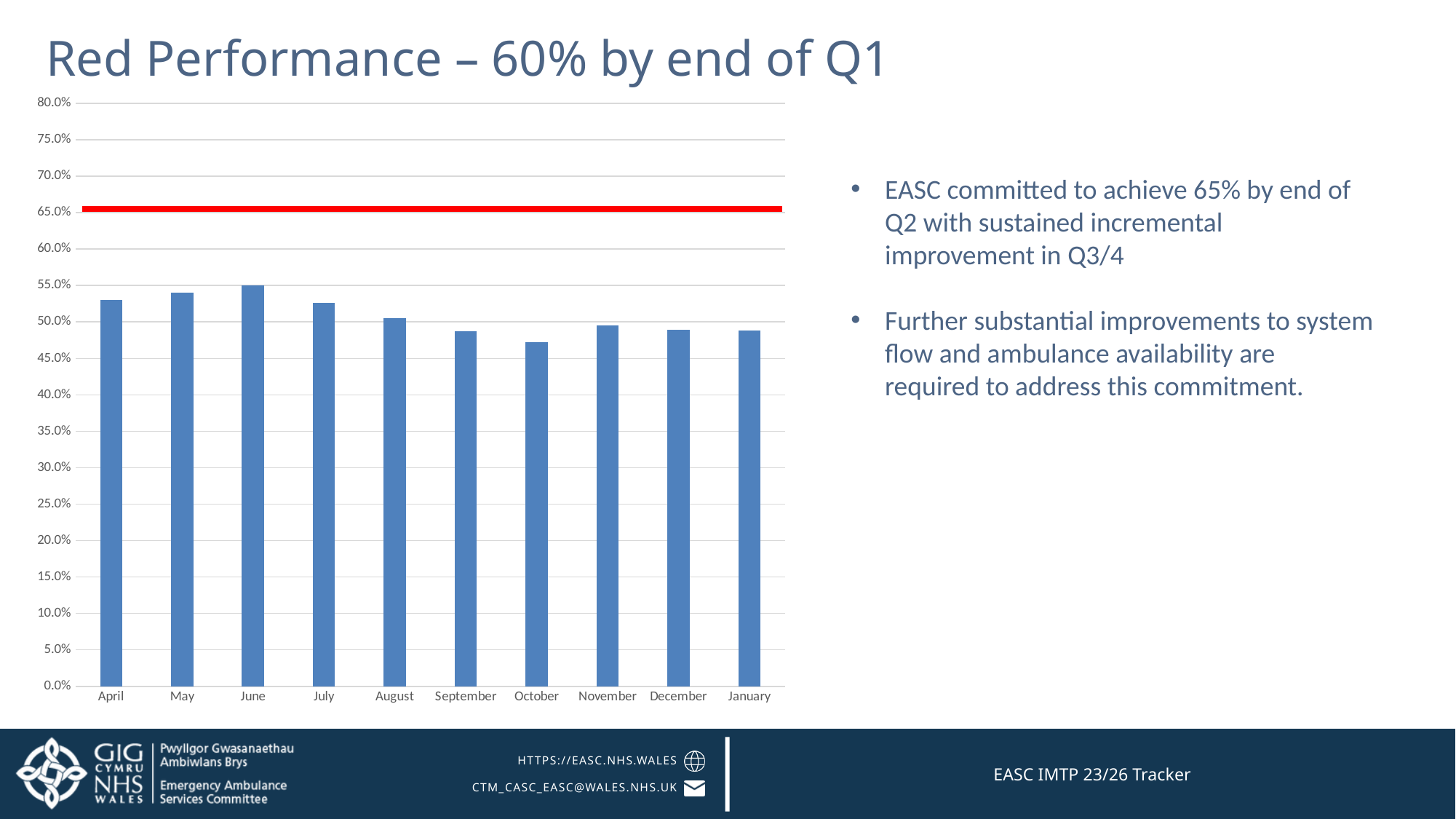
Is the value for June greater or less than 60.0%? less Which month has the larger value, June or January? June Do the values generally rise or fall from June to October? fall Which month has the larger value, April or October? April Is the value for September greater or less than 50.0%? less Which month has the highest Red Performance value? June How many months are shown on the x axis of the chart? 10 At what level on the y axis is the red horizontal line drawn? 65.0% Which month has the lowest Red Performance value? October What kind of chart is shown on the slide? bar chart Is the value for April greater or less than 50.0%? greater